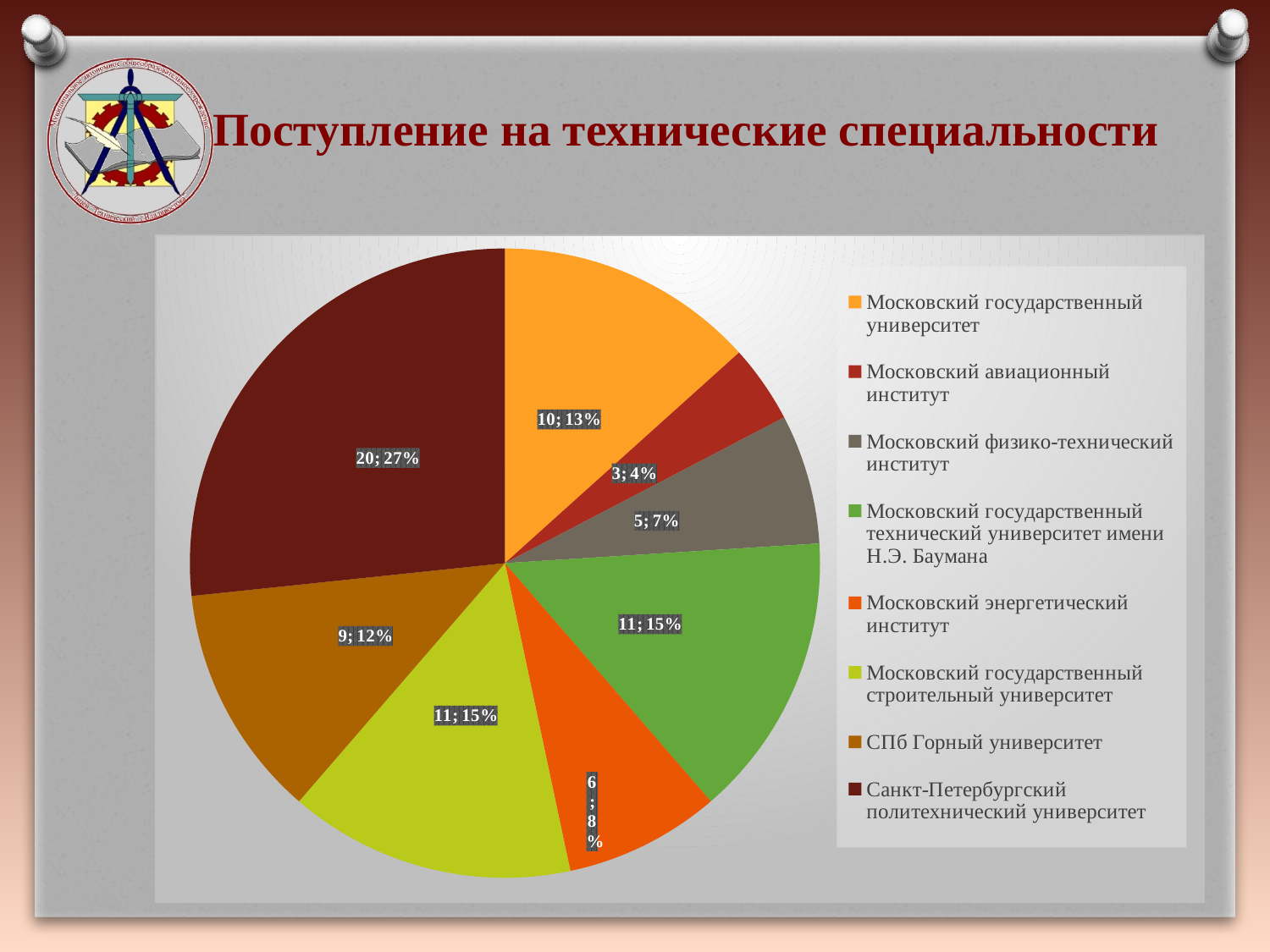
Which is larger, the value for Московский государственный университет or the value for Московский энергетический институт? Московский государственный университет Which university has the largest slice? Санкт-Петербургский политехнический университет Which university has the smallest slice? Московский авиационный институт What is the difference between the values for Санкт-Петербургский политехнический университет and СПб Горный университет? 11 What share of the pie does Санкт-Петербургский политехнический университет have? 27% How many slices does the pie chart have? 8 What share of the pie does СПб Горный университет have? 12% What kind of chart is shown on the slide? pie chart What is the value for Санкт-Петербургский политехнический университет? 20 What is the value for Московский авиационный институт? 3 What share of the pie does Московский физико-технический институт have? 7% What is the title of the chart? Поступление на технические специальности